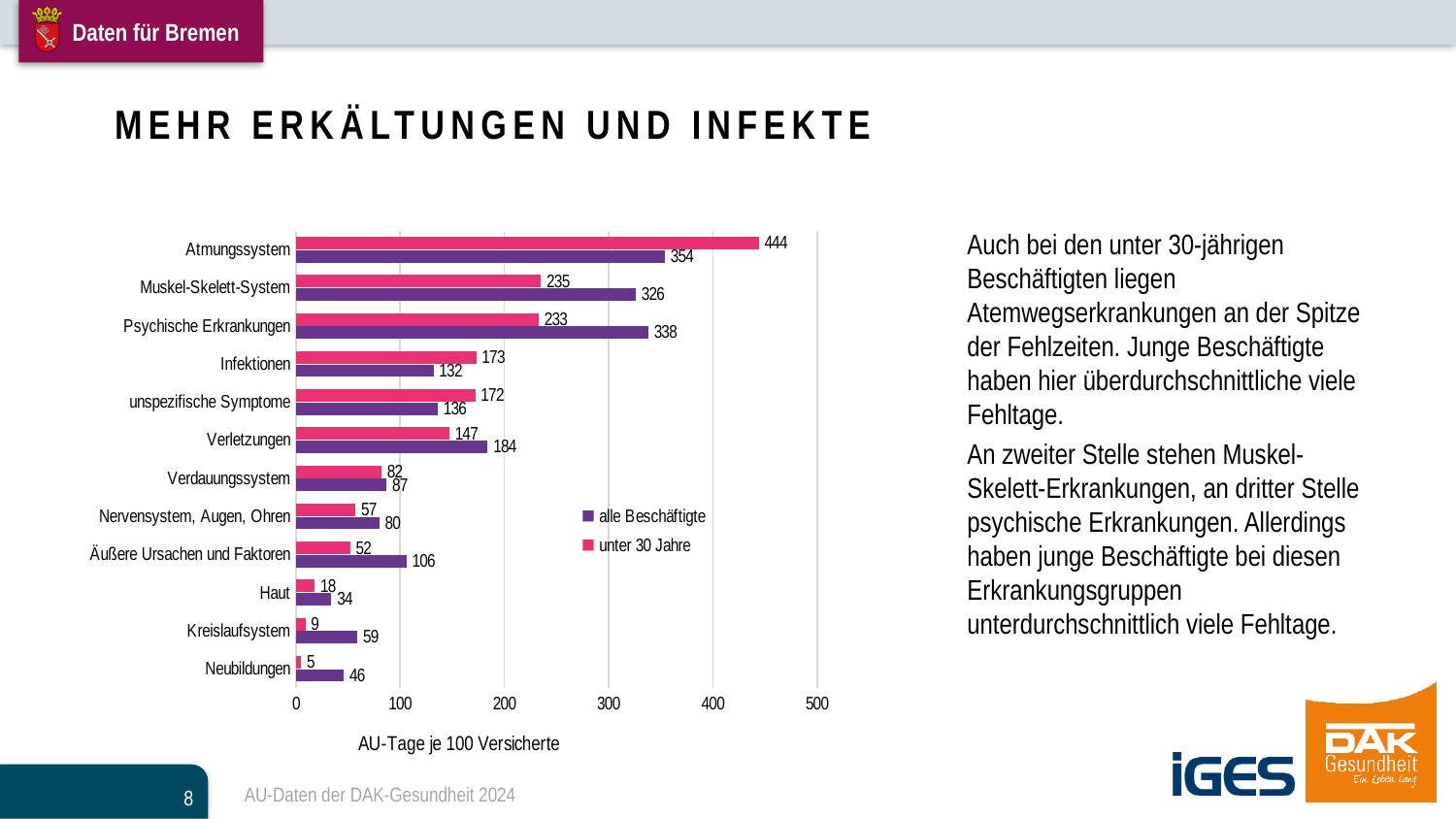
What is the difference between the 'unter 30 Jahre' and 'alle Beschäftigte' values for Atmungssystem? 90 For Verletzungen, which series has the larger value: 'alle Beschäftigte' or 'unter 30 Jahre'? alle Beschäftigte How many series does the legend list? 2 Which category has the lowest value for 'unter 30 Jahre'? Neubildungen What is the value for 'alle Beschäftigte' in the Psychische Erkrankungen category? 338 How many categories are shown on the chart? 12 What is the value for 'unter 30 Jahre' in the Atmungssystem category? 444 Which category has the highest value for 'alle Beschäftigte'? Atmungssystem What is the value for 'unter 30 Jahre' in the Kreislaufsystem category? 9 What is the difference between the 'alle Beschäftigte' and 'unter 30 Jahre' values for Äußere Ursachen und Faktoren? 54 What kind of chart is shown on the slide? bar chart What is the label of the horizontal axis of the chart? AU-Tage je 100 Versicherte